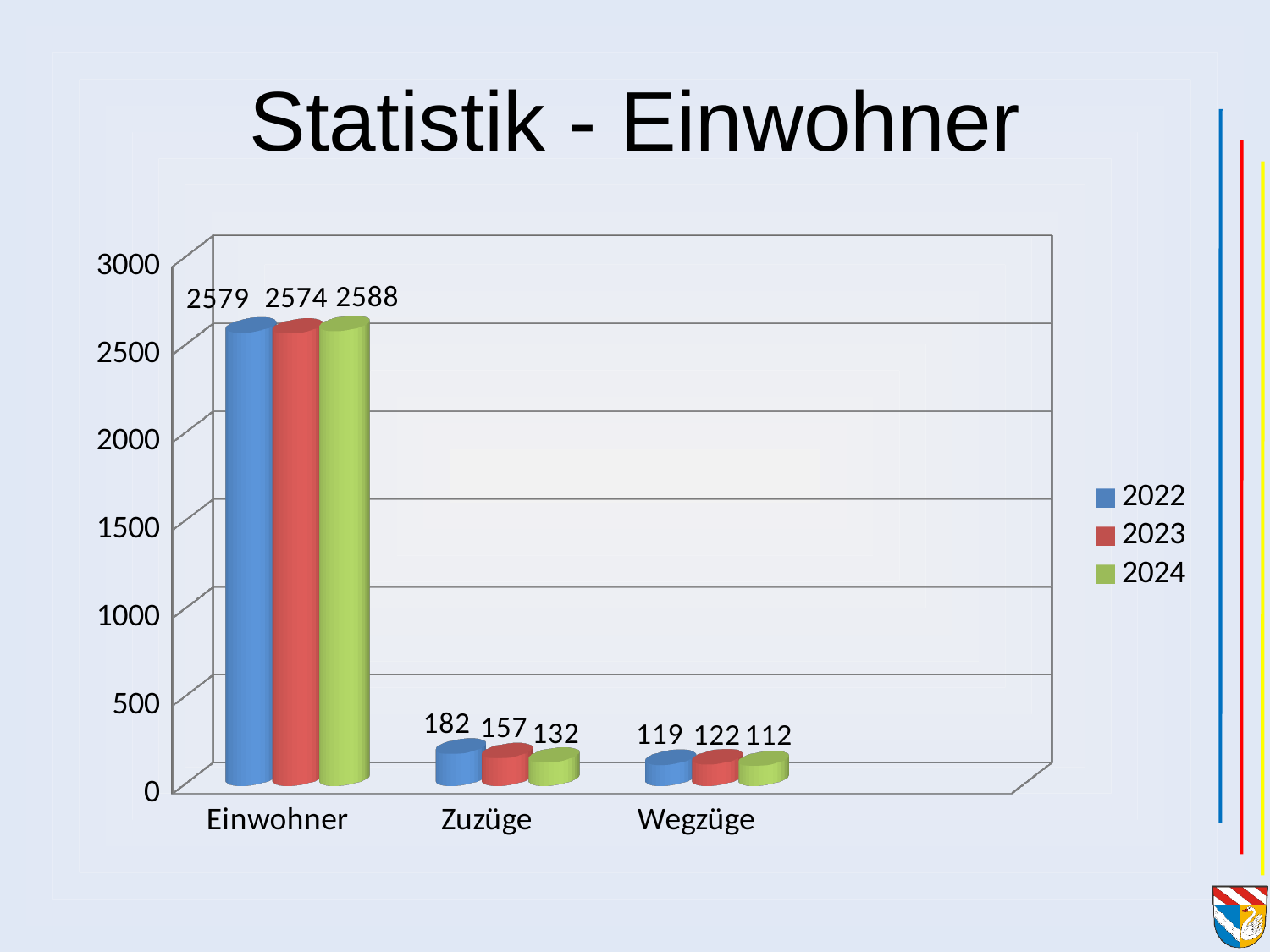
Which year has the highest value for Zuzüge? 2022 What is the value for Einwohner in 2024? 2588 What is the value for Wegzüge in 2023? 122 Is the value for Einwohner in 2022 greater or less than 2500? greater What is the difference between the Zuzüge values for 2022 and 2024? 50 What is the value for Zuzüge in 2022? 182 What is the difference between the Einwohner values for 2024 and 2023? 14 Which year has the lowest value for Wegzüge? 2024 How many categories are shown on the x axis? 3 What kind of chart is shown on the slide? Bar chart How many series does the legend list? 3 Which is larger: Zuzüge in 2023 or Wegzüge in 2023? Zuzüge in 2023